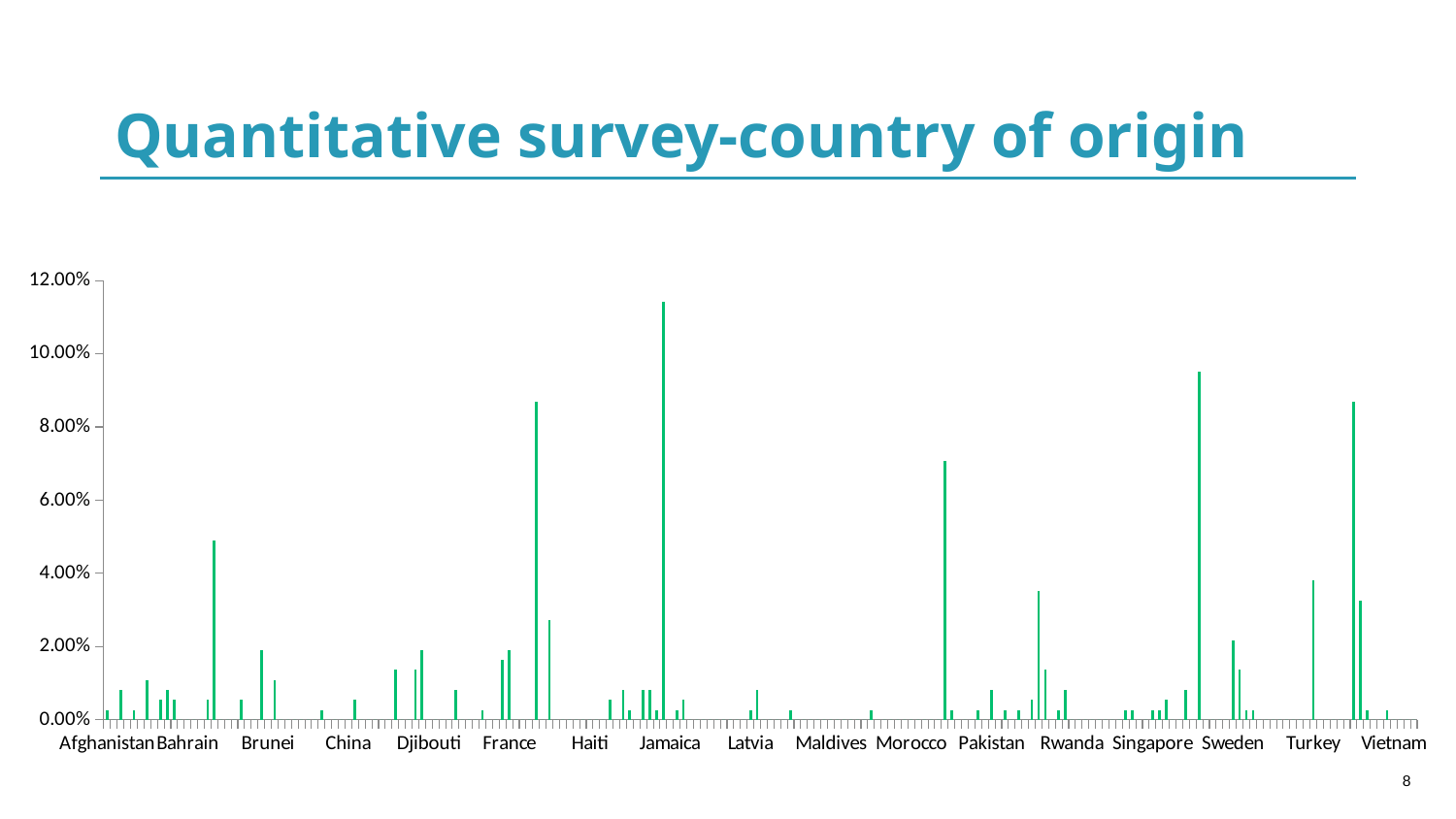
How many bars in the chart exceed 10.00%? 1 How many bars in the chart exceed 6.00%? 5 What kind of chart is shown on the slide? bar chart Is the value for Vietnam greater or less than 2.00%? less How many bars in the chart exceed 8.00%? 4 Does any bar in the chart reach 12.00%? No Is the value for Afghanistan greater or less than 2.00%? less Which country label appears first on the horizontal axis? Afghanistan What is the highest value shown on the vertical axis of the chart? 12.00% What is the title of the slide containing the chart? Quantitative survey-country of origin